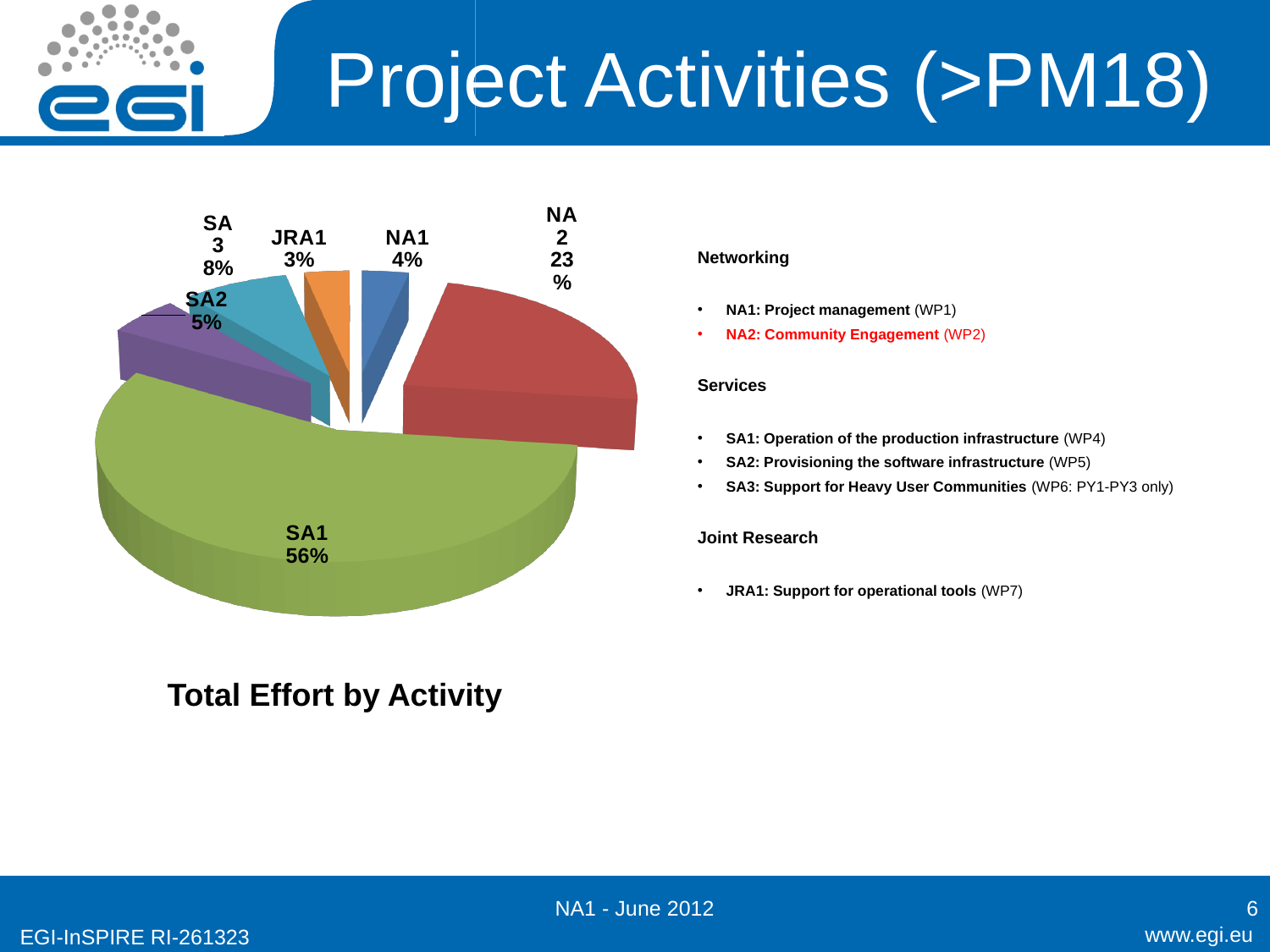
What is the title of the chart? Total Effort by Activity What share of the pie does JRA1 have? 3% What colour is the SA1 slice? Green Which activity has the largest share of the pie? SA1 What is the difference in percentage points between SA1 and NA2? 33 Which has a larger share, SA2 or NA1? SA2 What share of the pie does SA3 have? 8% What share of the pie does SA1 have? 56% How many slices does the pie chart have? 6 What kind of chart is shown on the slide? Pie chart What share of the pie does NA2 have? 23% Which activity has the smallest share of the pie? JRA1